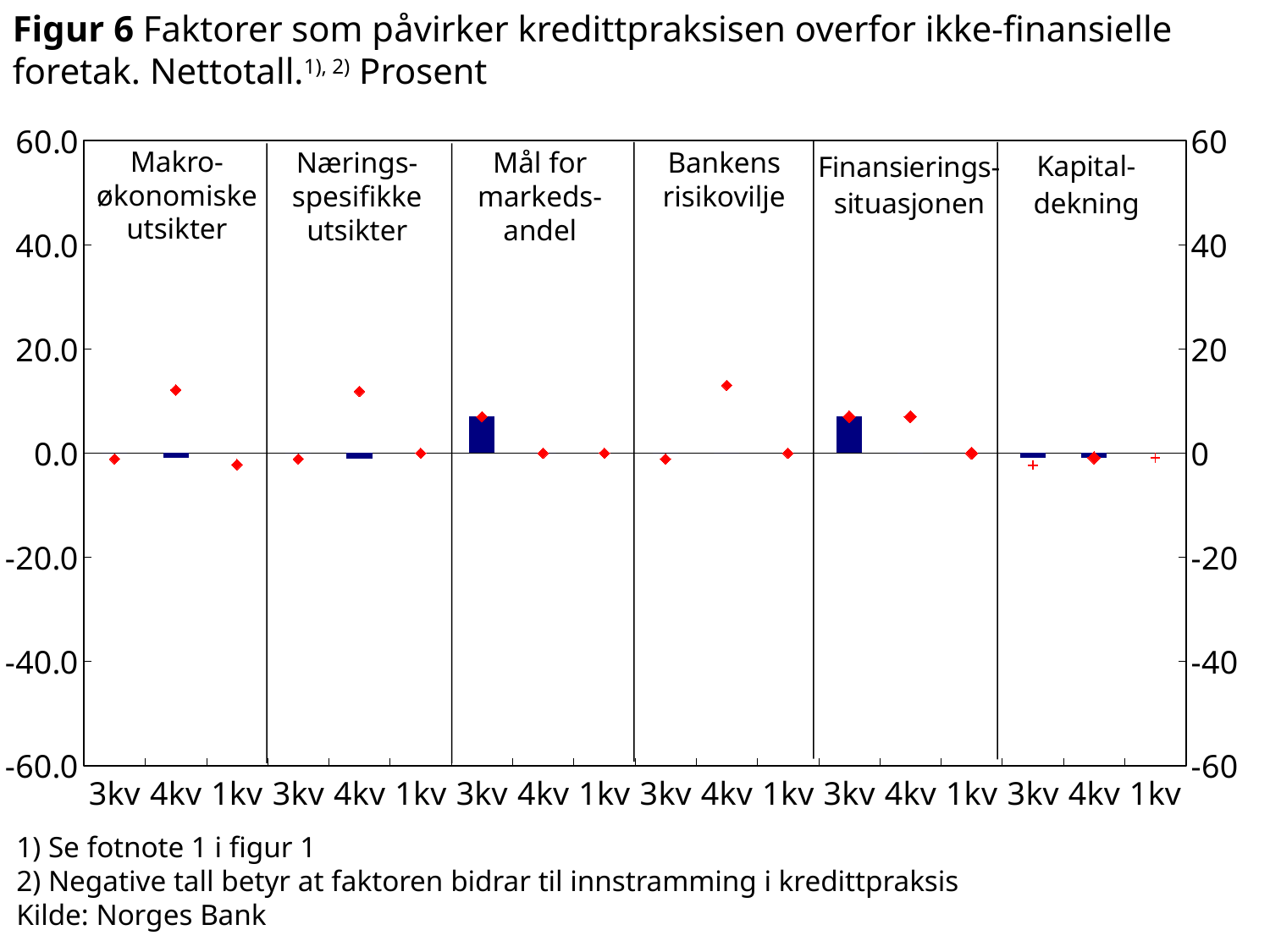
Is the 3kv bar for Finansieringssituasjonen greater or less than 20? less Which is larger: the 3kv bar for Mål for markedsandel or the 3kv bar for Kapitaldekning? Mål for markedsandel What is the highest value shown on the left vertical axis? 60.0 Is the 4kv marker for Bankens risikovilje greater or less than 20? less Is the 3kv bar for Kapitaldekning greater or less than 0? less How many factor panels are shown in the chart? 6 What source is cited below the chart? Norges Bank What kind of chart is shown in Figur 6? Bar chart How many quarters (x-axis labels) are shown within each factor panel? 3